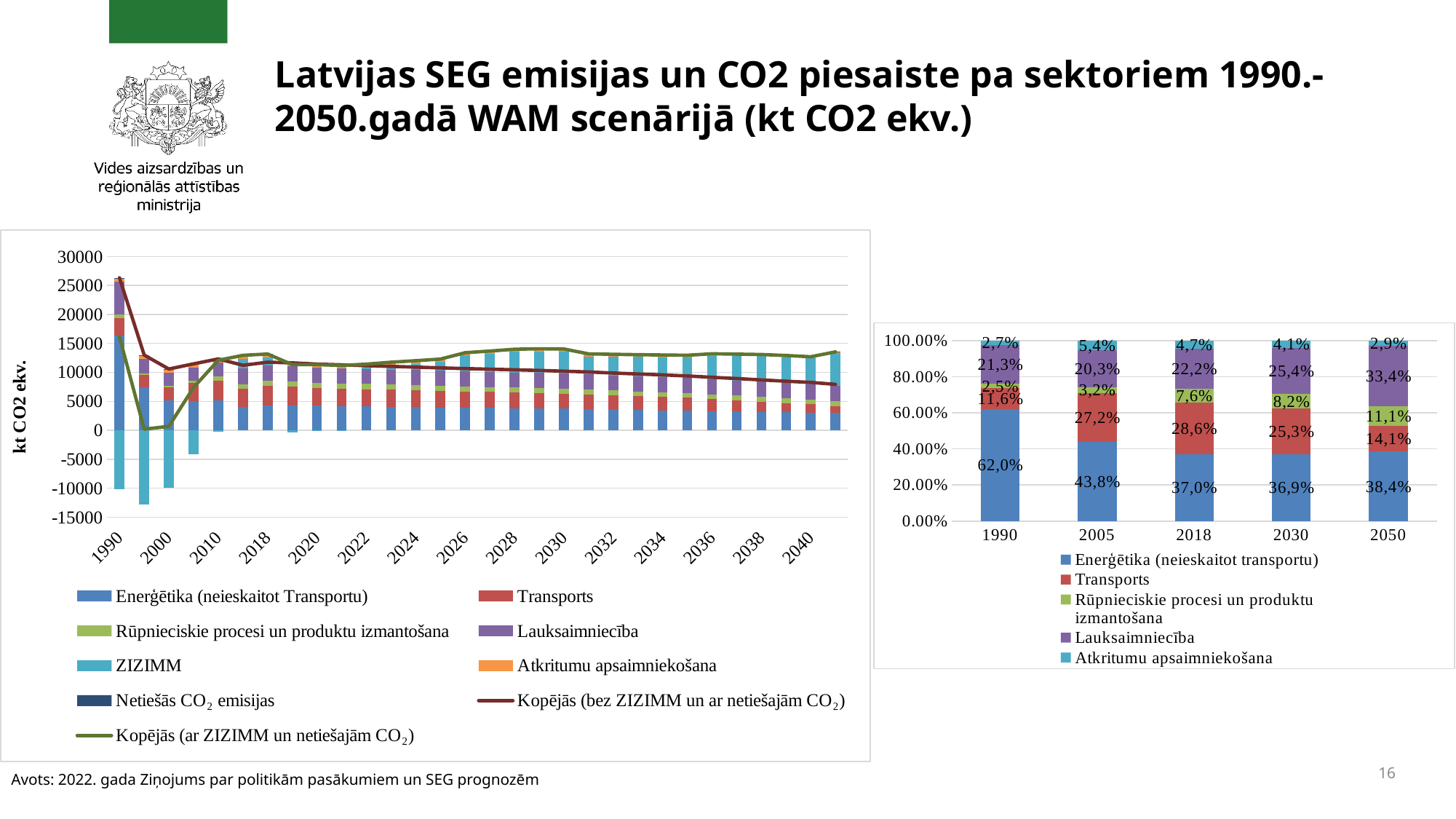
In the right chart, what is the share of Transports in 2018? 28,6% In the right chart, how many years are shown on the x axis? 5 In the right chart, what is the share of Lauksaimniecība in 2050? 33,4% In the left chart, how many entries does the legend list? 9 In the right chart, what is the share of Enerģētika (neieskaitot transportu) in 1990? 62,0% In the right chart, what is the difference between the Enerģētika (neieskaitot transportu) share in 1990 and in 2005? 18,2% In the right chart, which is larger in 2050: the share of Transports or the share of Lauksaimniecība? Lauksaimniecība In the right chart, in which year is the share of Transports highest? 2018 In the right chart, what is the share of Rūpnieciskie procesi un produktu izmantošana in 2030? 8,2% What type of chart is the right chart? Stacked bar chart In the right chart, in which year is the share of Atkritumu apsaimniekošana lowest? 1990 In the left chart, is the ZIZIMM value for 1990 greater or less than -5000? less